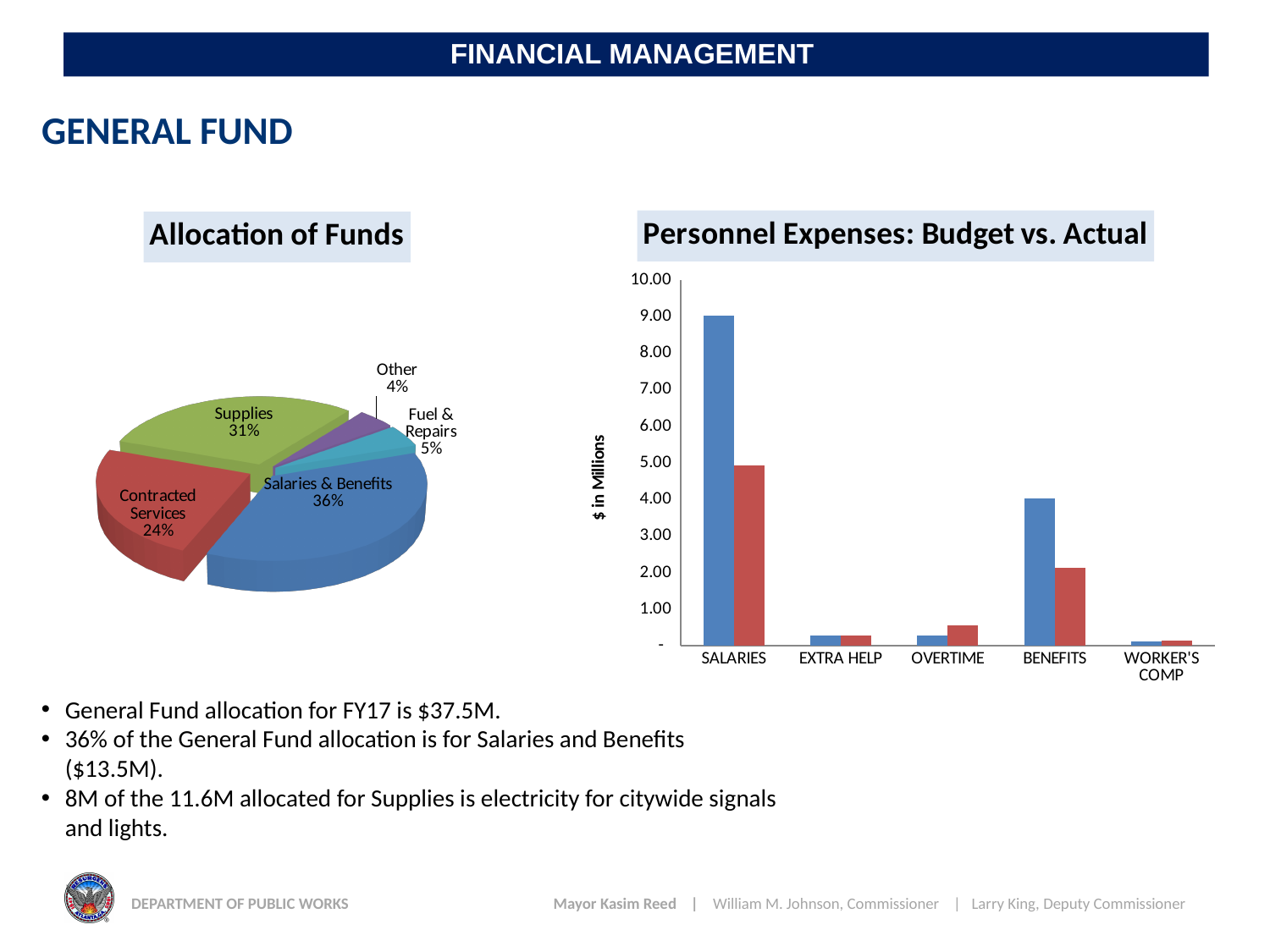
What type of chart is the Allocation of Funds chart? Pie chart In the Personnel Expenses: Budget vs. Actual chart, is the blue bar for SALARIES greater or less than 8.00? greater What type of chart is the Personnel Expenses: Budget vs. Actual chart? Bar chart In the Personnel Expenses: Budget vs. Actual chart, which category has the tallest bar? SALARIES In the Allocation of Funds pie chart, how many categories are shown? 5 In the Allocation of Funds pie chart, which category has the largest share? Salaries & Benefits In the Allocation of Funds pie chart, what is the difference in percentage points between Salaries & Benefits and Supplies? 5 In the Allocation of Funds pie chart, which is larger, Fuel & Repairs or Other? Fuel & Repairs In the Allocation of Funds pie chart, what share of funds goes to Supplies? 31% In the Personnel Expenses: Budget vs. Actual chart, how many categories are shown on the x axis? 5 In the Allocation of Funds pie chart, which category has the smallest share? Other In the Allocation of Funds pie chart, what share of funds goes to Contracted Services? 24%